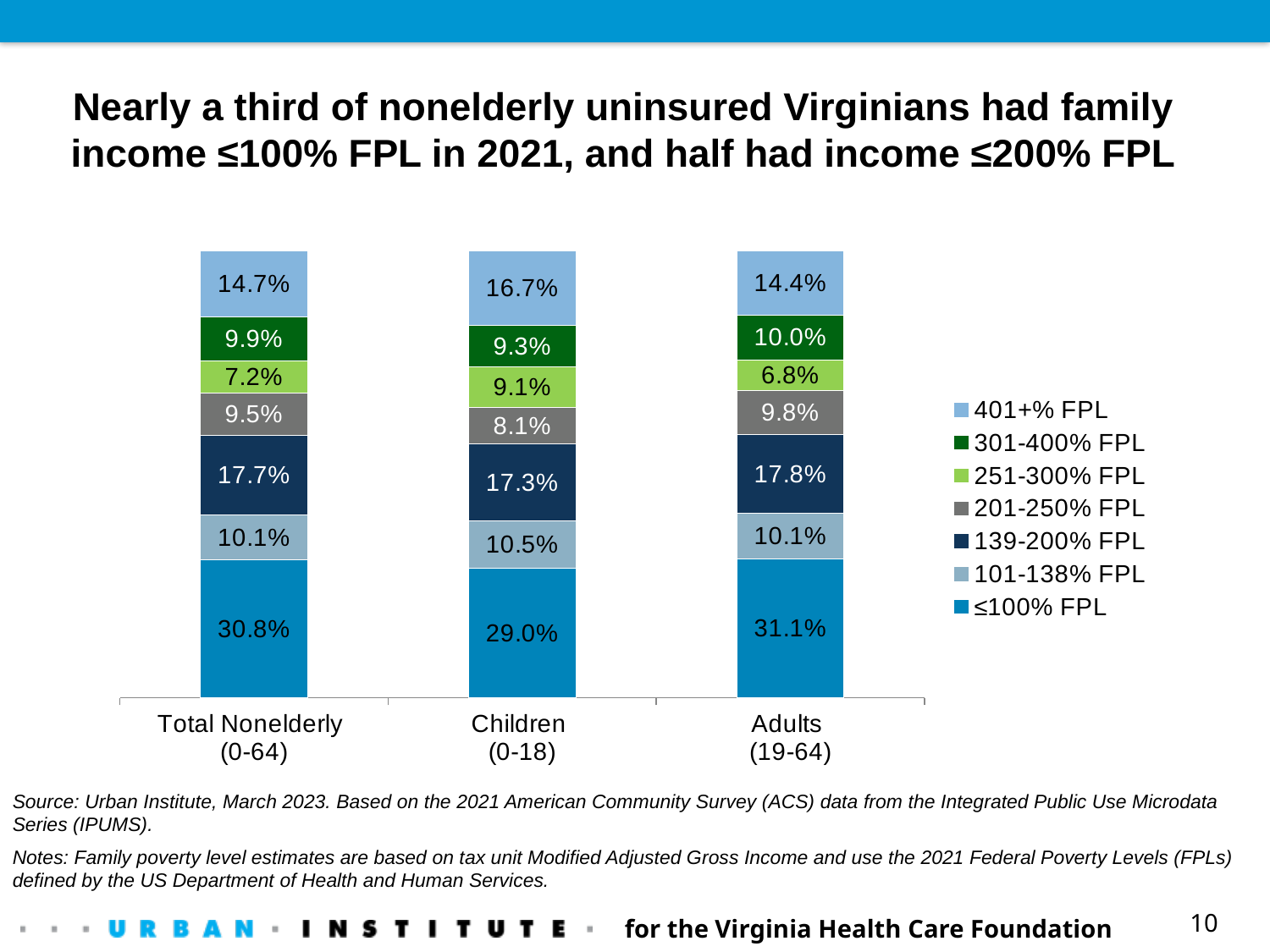
How many categories are shown along the x axis? 3 What is the 139-200% FPL value for Adults (19-64)? 17.8% Which is larger, the 201-250% FPL value for Total Nonelderly (0-64) or for Children (0-18)? Total Nonelderly (0-64) Which legend entry is shown in the darkest green colour? 301-400% FPL What is the ≤100% FPL value for Children (0-18)? 29.0% Which category has the highest ≤100% FPL value? Adults (19-64) What kind of chart is shown on the slide? Stacked bar chart What is the 401+% FPL value for Total Nonelderly (0-64)? 14.7% Which category has the lowest 251-300% FPL value? Adults (19-64) What is the total of the stacked bar for Adults (19-64)? 100.0% How many series does the legend list? 7 What is the difference between the 401+% FPL values for Children (0-18) and Adults (19-64)? 2.3%